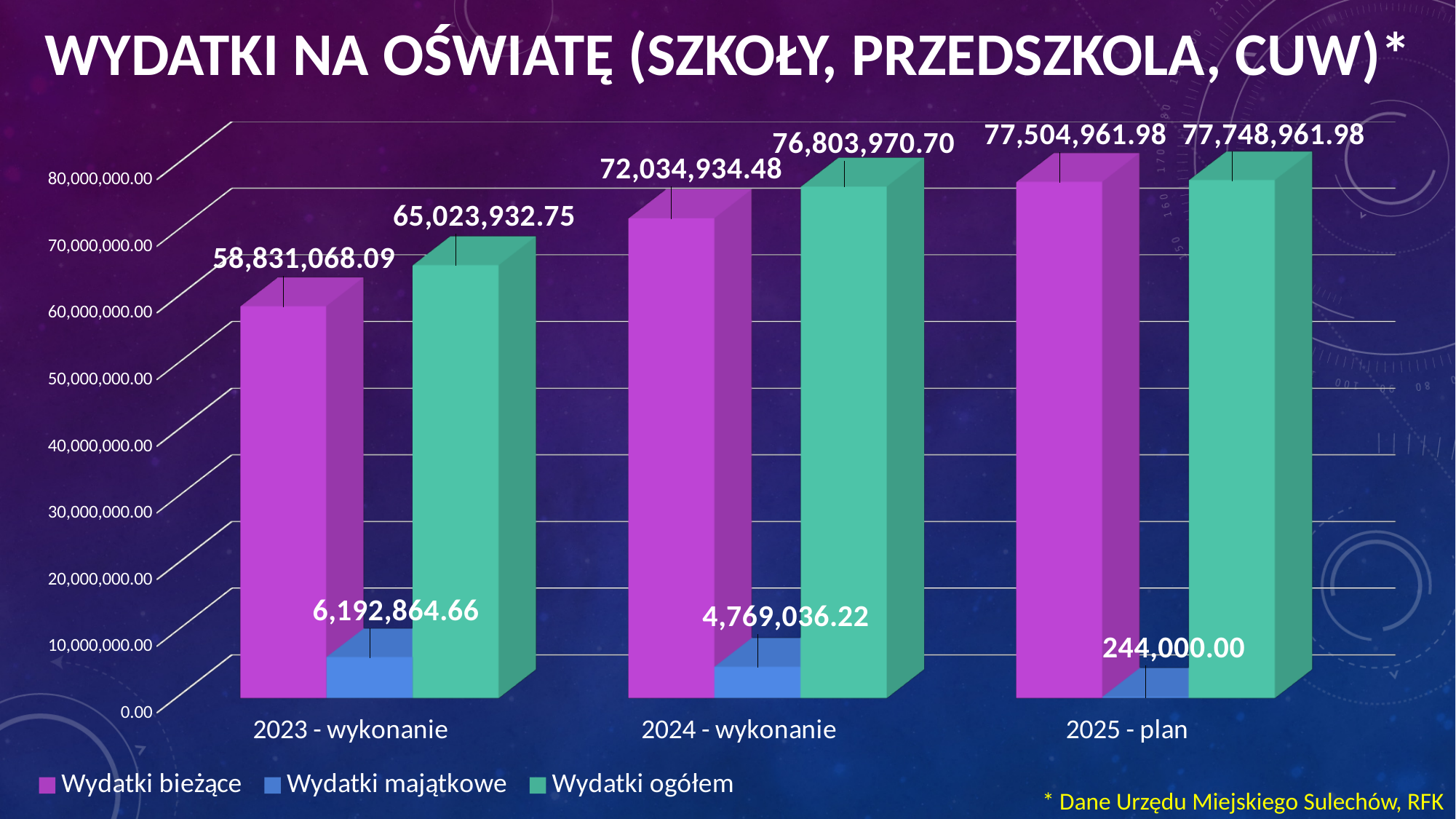
What is the difference between Wydatki majątkowe for 2023 - wykonanie and 2024 - wykonanie? 1,423,828.44 How many categories are shown on the x axis? 3 What is the value of Wydatki bieżące for 2023 - wykonanie? 58,831,068.09 Which category has the lowest value of Wydatki majątkowe? 2025 - plan How many series does the legend list? 3 What is the value of Wydatki majątkowe for 2025 - plan? 244,000.00 Which is larger: Wydatki ogółem for 2023 - wykonanie or Wydatki bieżące for 2024 - wykonanie? Wydatki bieżące for 2024 - wykonanie Do the values of Wydatki bieżące rise or fall from 2023 - wykonanie to 2025 - plan? Rise What is the difference between Wydatki bieżące for 2024 - wykonanie and 2023 - wykonanie? 13,203,866.39 Which category has the highest value of Wydatki ogółem? 2025 - plan What is the value of Wydatki ogółem for 2024 - wykonanie? 76,803,970.70 What kind of chart is shown on the slide? Bar chart